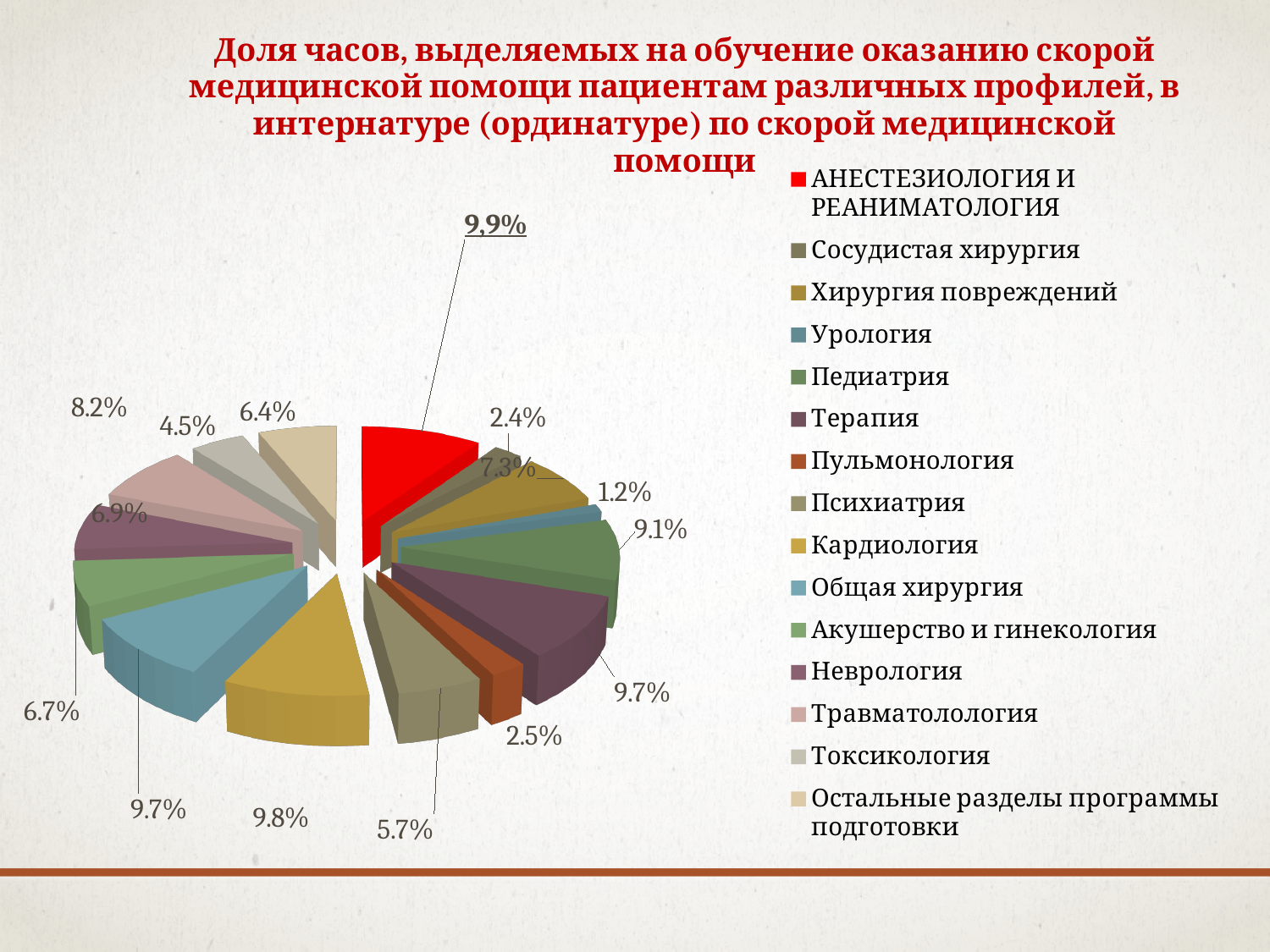
What is the share shown for Кардиология? 9.8% What is the share shown for Урология? 1.2% Which has a larger share, Педиатрия or Травматолология? Педиатрия Which category has the largest share in the pie chart? АНЕСТЕЗИОЛОГИЯ И РЕАНИМАТОЛОГИЯ What is the difference between the largest slice (9,9%) and the smallest slice (1.2%)? 8.7 percentage points Which category has the smallest share in the pie chart? Урология What colour is the slice for АНЕСТЕЗИОЛОГИЯ И РЕАНИМАТОЛОГИЯ? red What kind of chart is shown on the slide? pie chart What is the share shown for Травматолология? 8.2% What share of hours is allocated to АНЕСТЕЗИОЛОГИЯ И РЕАНИМАТОЛОГИЯ (the red slice)? 9,9% How many categories does the legend of the pie chart list? 15 What is the share shown for Токсикология? 4.5%